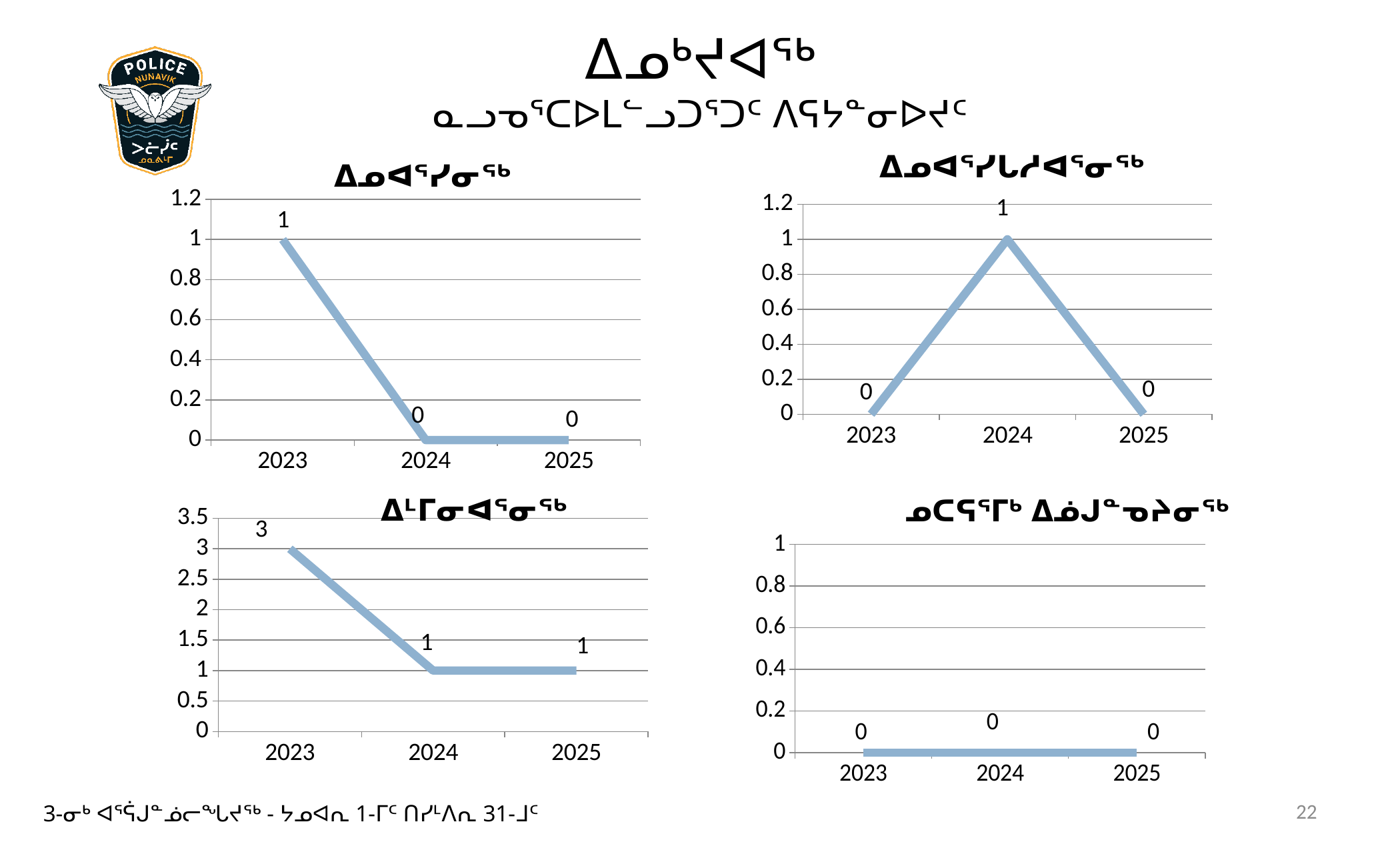
In the bottom-left chart, what is the difference between the values for 2023 and 2024? 2 In the bottom-right chart, what is the value for 2025? 0 In the top-right chart, what is the value for 2024? 1 In the bottom-left chart, what is the value for 2023? 3 In the top-left chart, what is the value for 2024? 0 In the bottom-left chart, do the values rise or fall from 2023 to 2024? fall What kind of chart is the top-left chart? line chart In the top-left chart, is the value for 2023 larger or smaller than the value for 2025? larger In the bottom-left chart, which year has the highest value? 2023 In the top-right chart, which year has the highest value? 2024 How many years are shown on the x axis of the bottom-right chart? 3 In the top-left chart, what is the value for 2023? 1